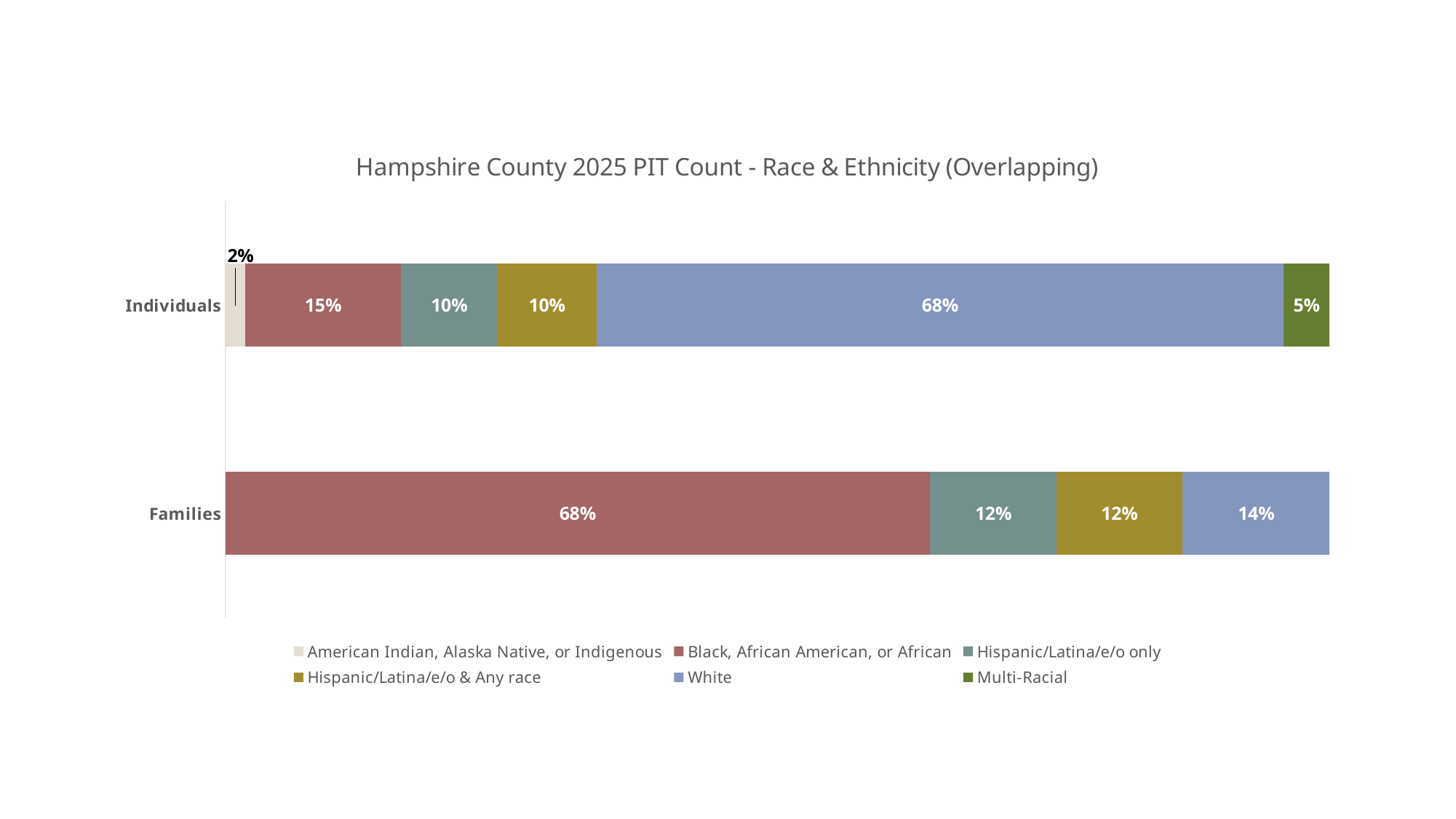
What is the value for American Indian, Alaska Native, or Indigenous in the Individuals bar? 2% Which series has the largest value in the Families bar? Black, African American, or African What is the difference between the White value for Individuals and the White value for Families? 54% What is the value for Multi-Racial in the Individuals bar? 5% How many category bars are shown in the chart? 2 What is the value for White in the Individuals bar? 68% What is the value for Black, African American, or African in the Families bar? 68% How many series does the legend list? 6 Which series has the smallest value in the Individuals bar? American Indian, Alaska Native, or Indigenous What is the value for White in the Families bar? 14% Is the Black, African American, or African value larger for Individuals or for Families? Families What type of chart is shown on the slide? Stacked bar chart